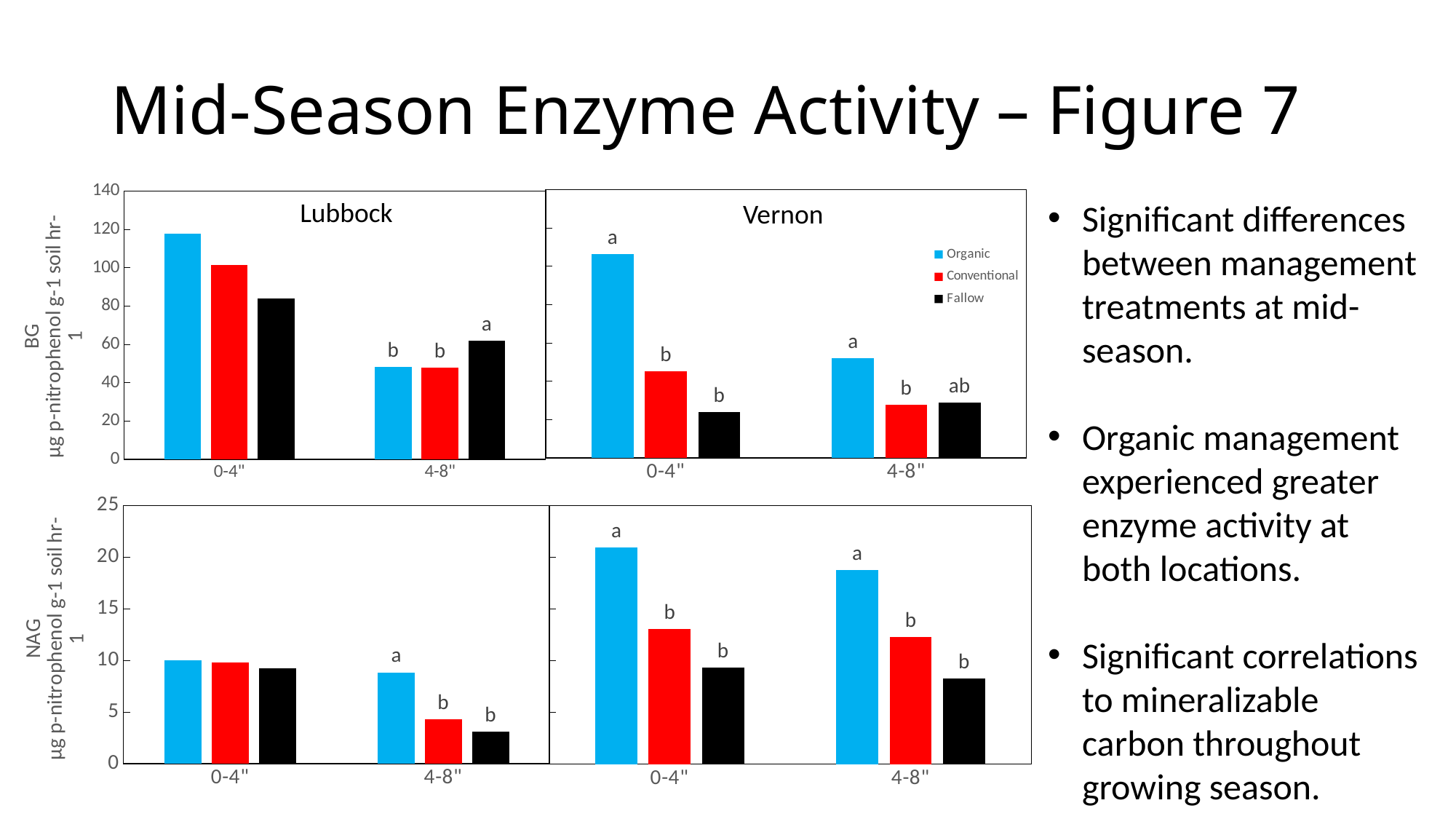
How many depth categories are shown on the x axis of each panel? 2 How many series does the legend in the Vernon BG panel list? 3 In the BG Lubbock panel, which treatment has the highest value at 4-8"? Fallow In the NAG Vernon panel at 0-4", which is larger, Organic or Conventional? Organic In the BG Lubbock panel, is the Organic value at 0-4" greater or less than 100? greater In the NAG Lubbock panel, which treatment has the lowest value at 4-8"? Fallow In the NAG Vernon panel, is the Organic value at 0-4" greater or less than 15? greater In the BG Lubbock panel, does the Organic value rise or fall from 0-4" to 4-8"? fall What kind of chart is used in the Figure 7 panels on this slide? bar chart In the BG Vernon panel, which treatment has the highest value at 0-4"? Organic What colour represents the Fallow treatment in the legend? black In the BG Vernon panel, is the Fallow value at 0-4" greater or less than 40? less